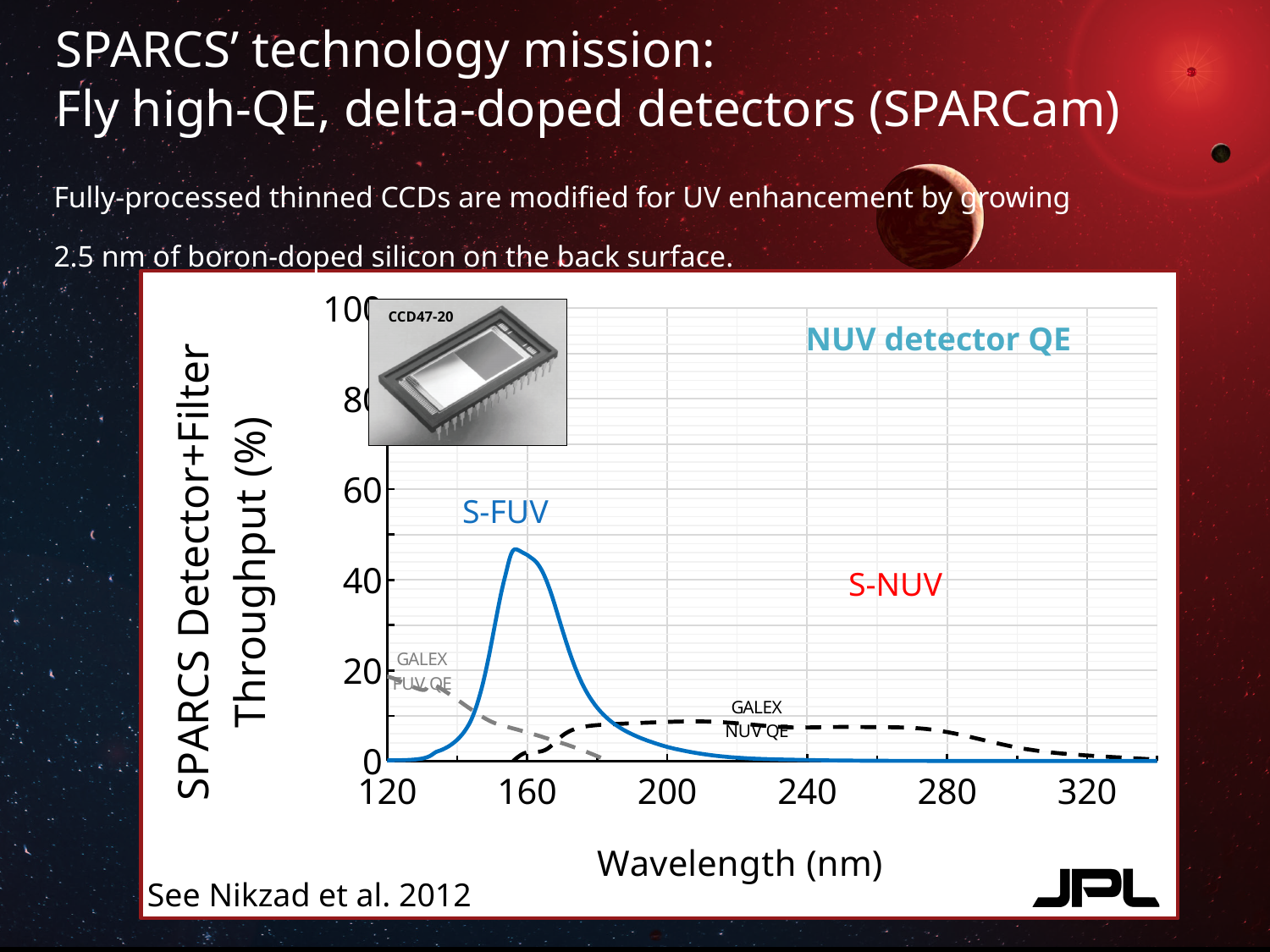
What is the label of the x axis of the chart? Wavelength (nm) What is the label of the y axis of the chart? SPARCS Detector+Filter Throughput (%) Which curve reaches a higher peak, S-FUV or GALEX NUV QE? S-FUV What kind of chart is shown on the slide? line chart Is the peak value of the S-FUV curve greater or less than 40? greater Does the S-FUV curve rise or fall between 160 nm and 240 nm? fall Does the GALEX FUV QE curve rise or fall between 120 nm and 180 nm? fall Is the peak value of the S-FUV curve greater or less than 60? less How many tick labels are shown on the x axis of the chart? 6 Is the GALEX NUV QE curve greater or less than 20 at 240 nm? less What is the highest wavelength tick label shown on the x axis? 320